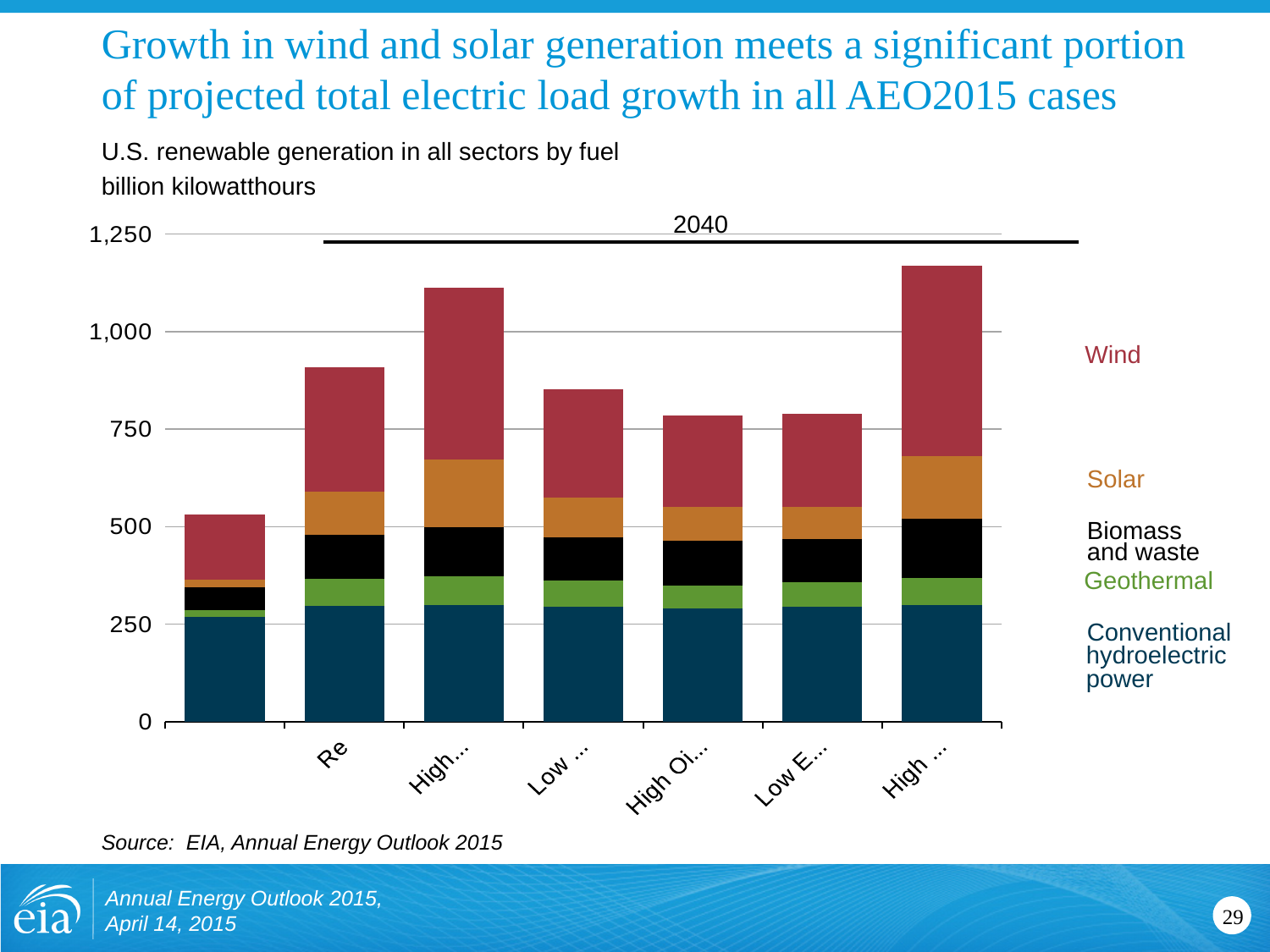
Is the total of the first bar greater or less than 750 billion kilowatthours? less Which has the larger total, the second bar or the fourth bar? The second bar Which bar has the highest total renewable generation? The seventh (rightmost) bar Is the total of the fifth bar greater or less than 1,000 billion kilowatthours? less Is the total of the third bar greater or less than 1,000 billion kilowatthours? greater How many series does the legend list? 5 Which bar has the lowest total renewable generation? The first (leftmost) bar What unit is the chart's y axis measured in? billion kilowatthours What kind of chart is shown on the slide? Stacked bar chart How many bars are plotted in the chart? 7 Which series is shown at the bottom of each stacked bar? Conventional hydroelectric power